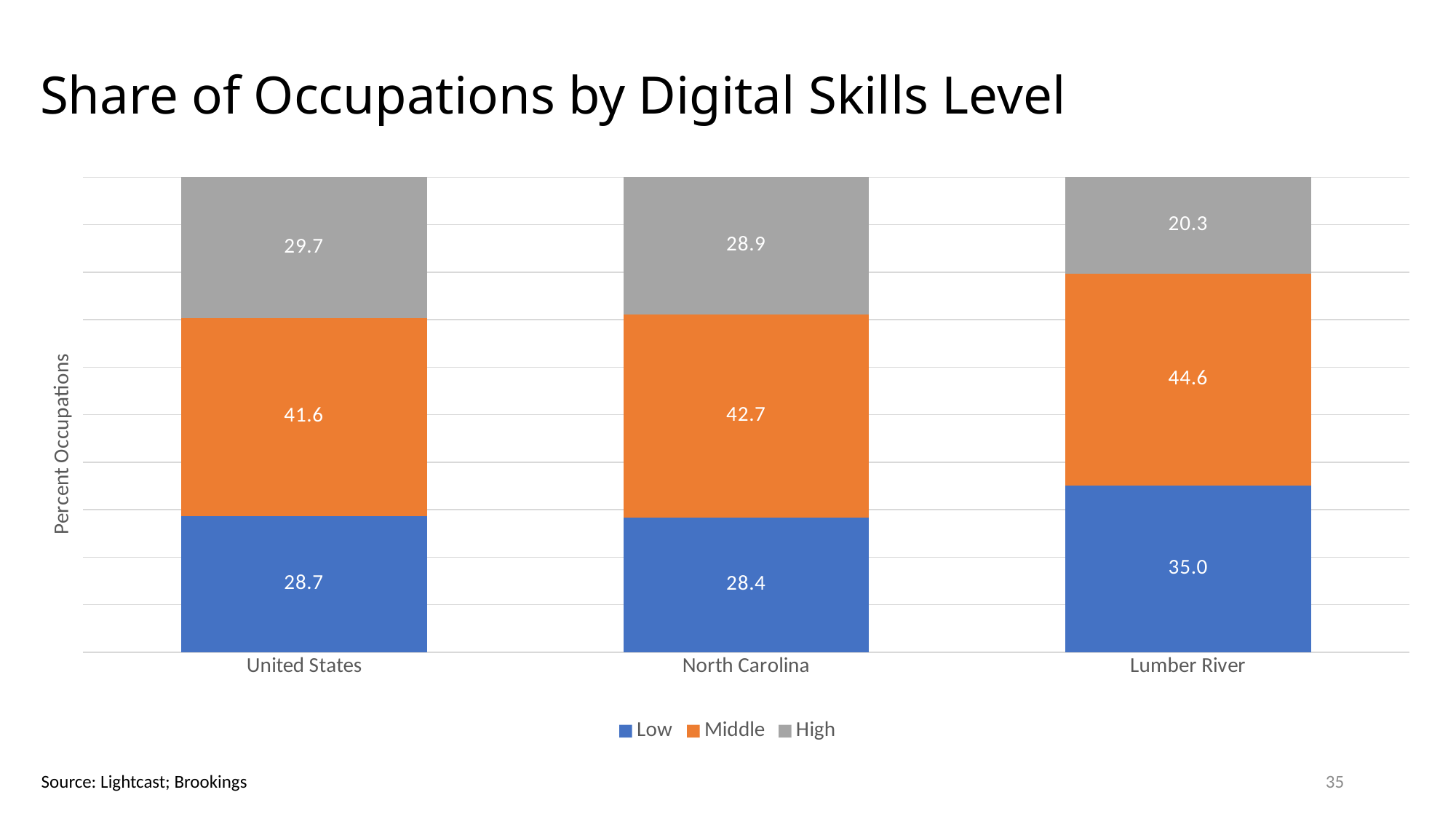
What is the title of the chart? Share of Occupations by Digital Skills Level How many categories are shown on the x axis? 3 What kind of chart is shown on the slide? Stacked bar chart How many series does the legend list? 3 What is the difference between the Low value for Lumber River and the Low value for the United States? 6.3 What is the High value for the United States? 29.7 What is the total of the stacked bar for North Carolina? 100.0 Which category has the highest Middle value? Lumber River What is the Low value for Lumber River? 35.0 Which is larger, the High value for the United States or the High value for North Carolina? United States What is the Middle value for North Carolina? 42.7 Which category has the lowest High value? Lumber River